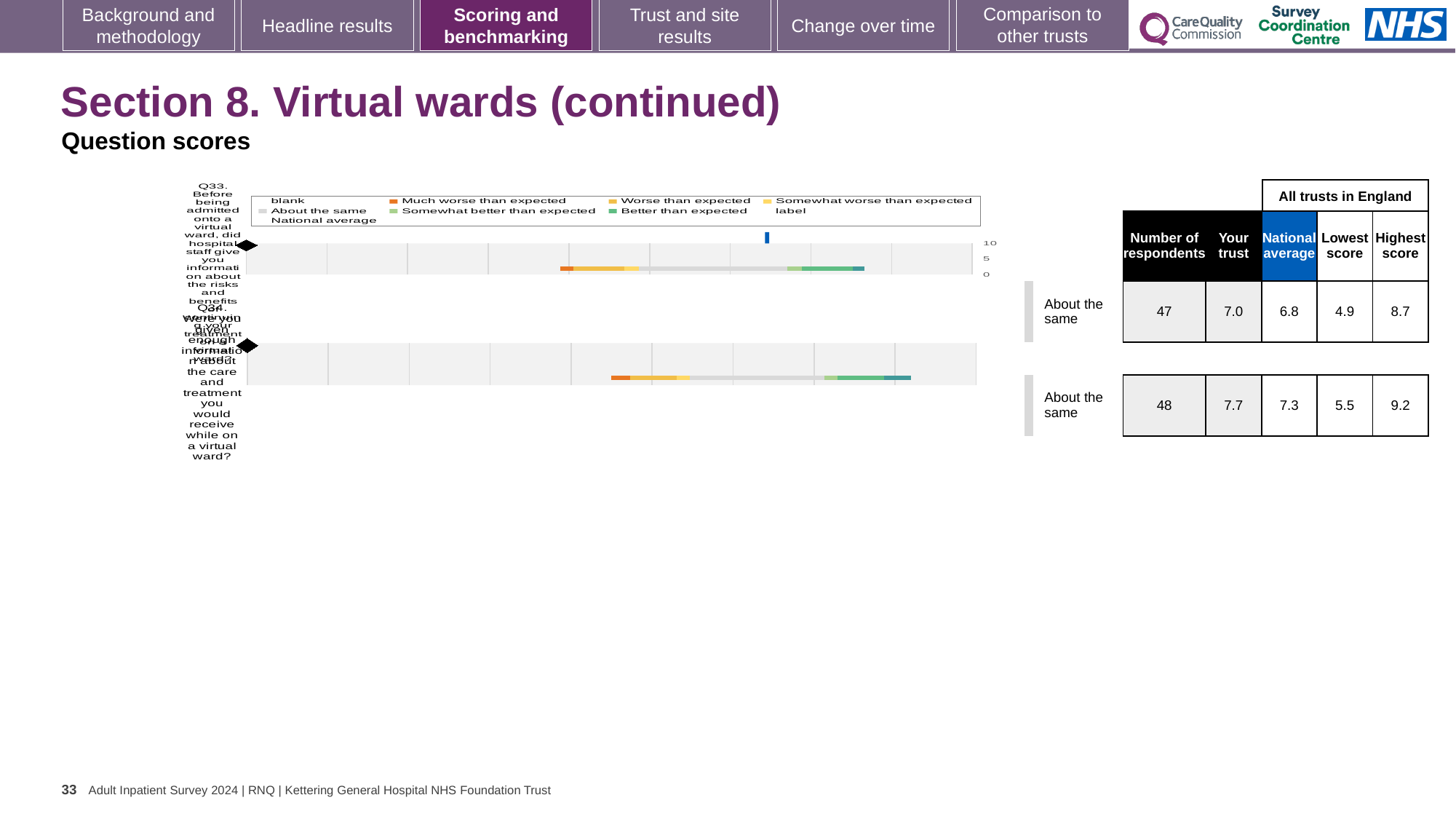
What is the national average score for Q33? 6.8 What is the difference between the highest and lowest scores for Q33? 3.8 For Q33, which is larger: the 'Your trust' score or the national average? Your trust Which colour in the legend represents 'Much worse than expected'? Orange What kind of chart is used to show the Q33 and Q34 question scores? bar chart What benchmark category is shown for Q33? About the same How many respondents answered Q34? 48 What is the 'Your trust' score for Q33? 7.0 What is the 'Your trust' score for Q34? 7.7 What is the highest score among all trusts in England for Q34? 9.2 What is the difference between the 'Your trust' score and the national average for Q34? 0.4 How many questions (bars) are plotted in the chart? 2